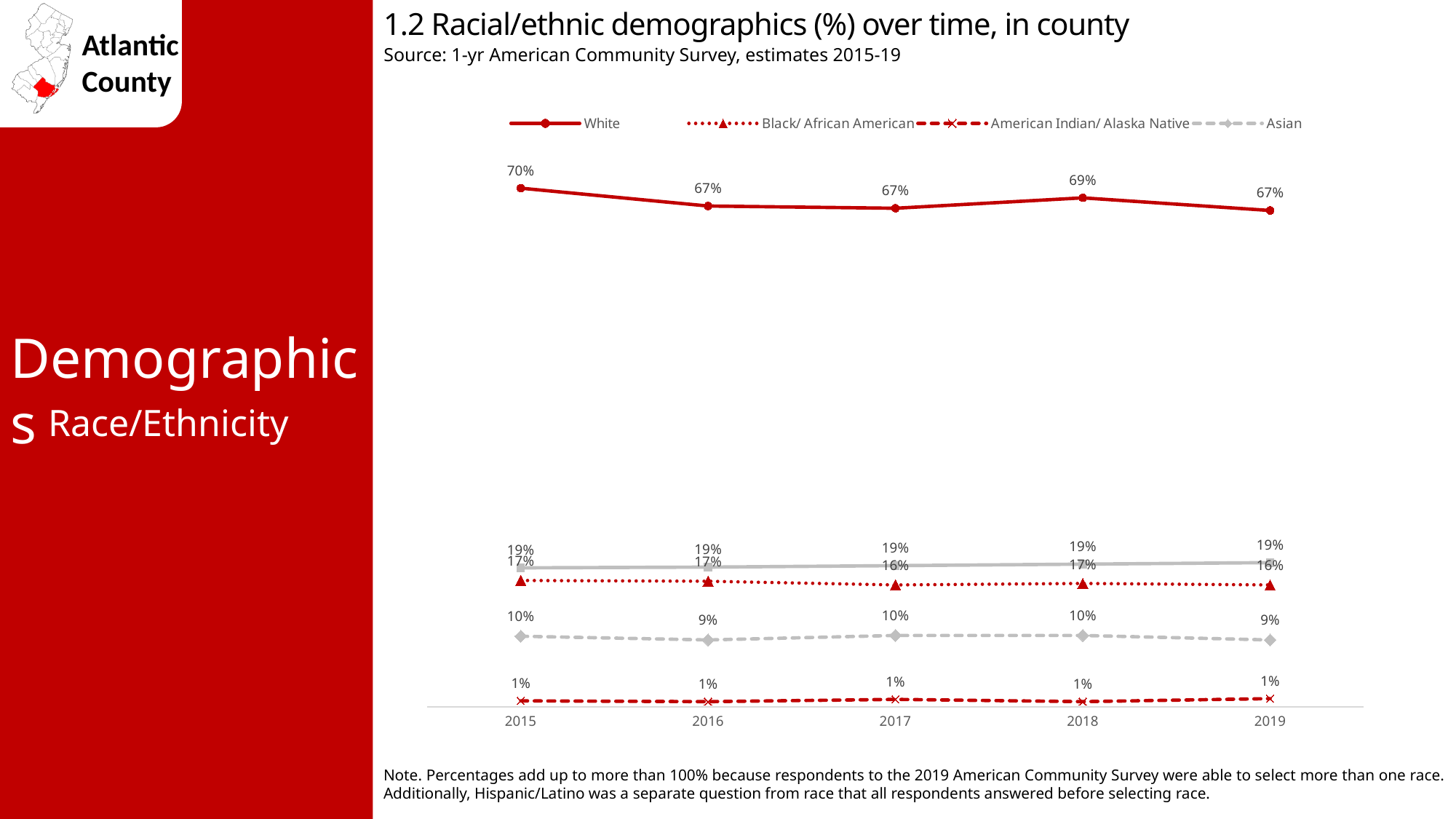
Which was larger in 2019, the Black/ African American percentage or the Asian percentage? Black/ African American What was the American Indian/ Alaska Native percentage in 2019? 1% Which series had the lowest values across all years? American Indian/ Alaska Native How many years are shown on the x axis? 5 What is the difference between the White percentage in 2015 and in 2016? 3% How many series does the legend list? 4 What was the Black/ African American percentage in 2017? 16% What was the Asian percentage in 2016? 9% What type of chart is shown on the slide? line chart What was the White percentage in 2018? 69% What was the White percentage in 2015? 70% In which year was the White percentage highest? 2015